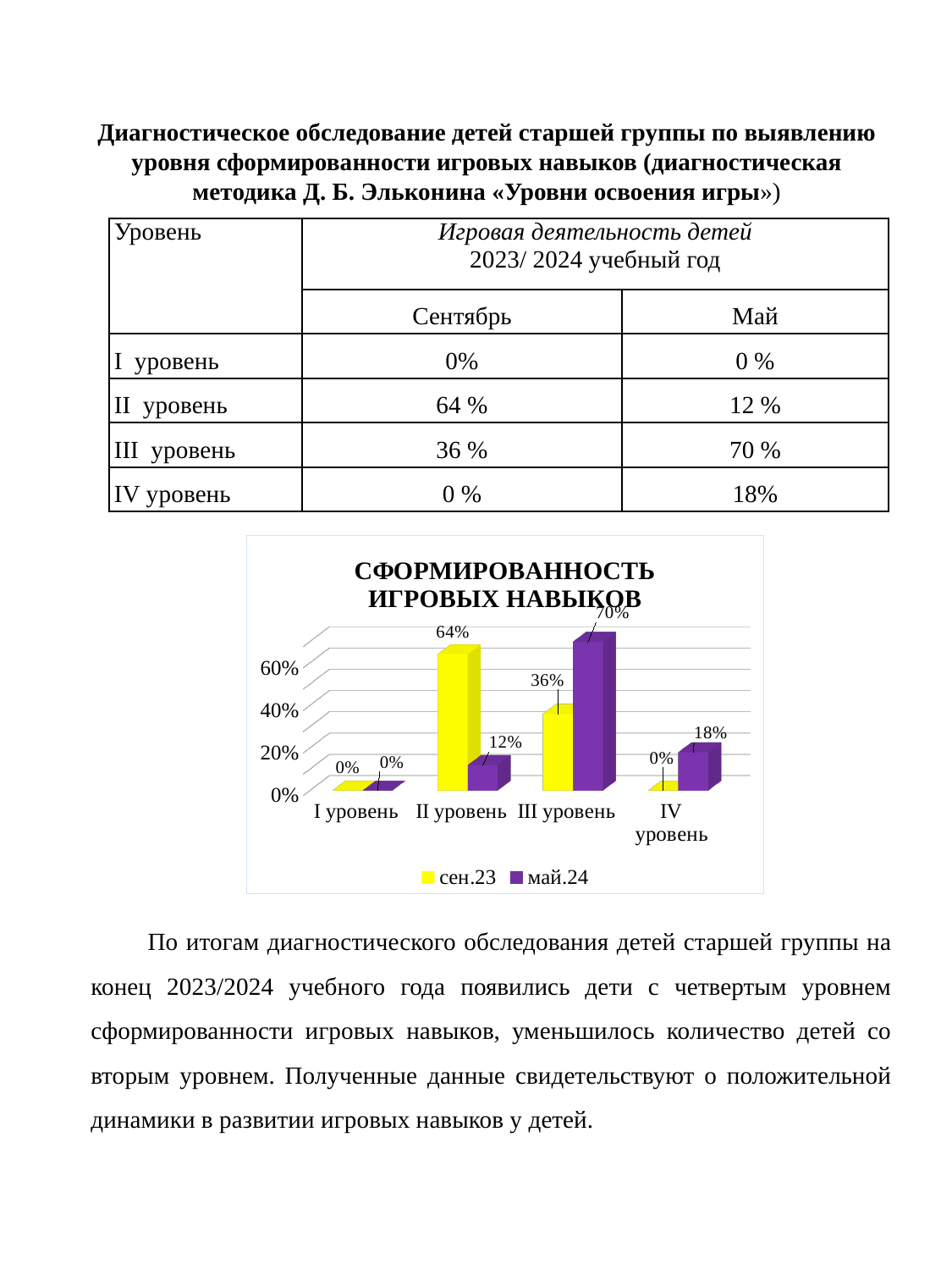
What is the title of the chart? СФОРМИРОВАННОСТЬ ИГРОВЫХ НАВЫКОВ What is the value for II уровень in the сен.23 series? 64% How many series does the legend list? 2 What is the value for II уровень in the май.24 series? 12% Which is larger for III уровень: the сен.23 value or the май.24 value? май.24 How many categories are shown on the x axis? 4 What is the value for IV уровень in the май.24 series? 18% Which category has the highest value in the сен.23 series? II уровень What kind of chart is shown? Bar chart Which category has the highest value in the май.24 series? III уровень What is the value for III уровень in the май.24 series? 70% What is the difference between the сен.23 and май.24 values for II уровень? 52%